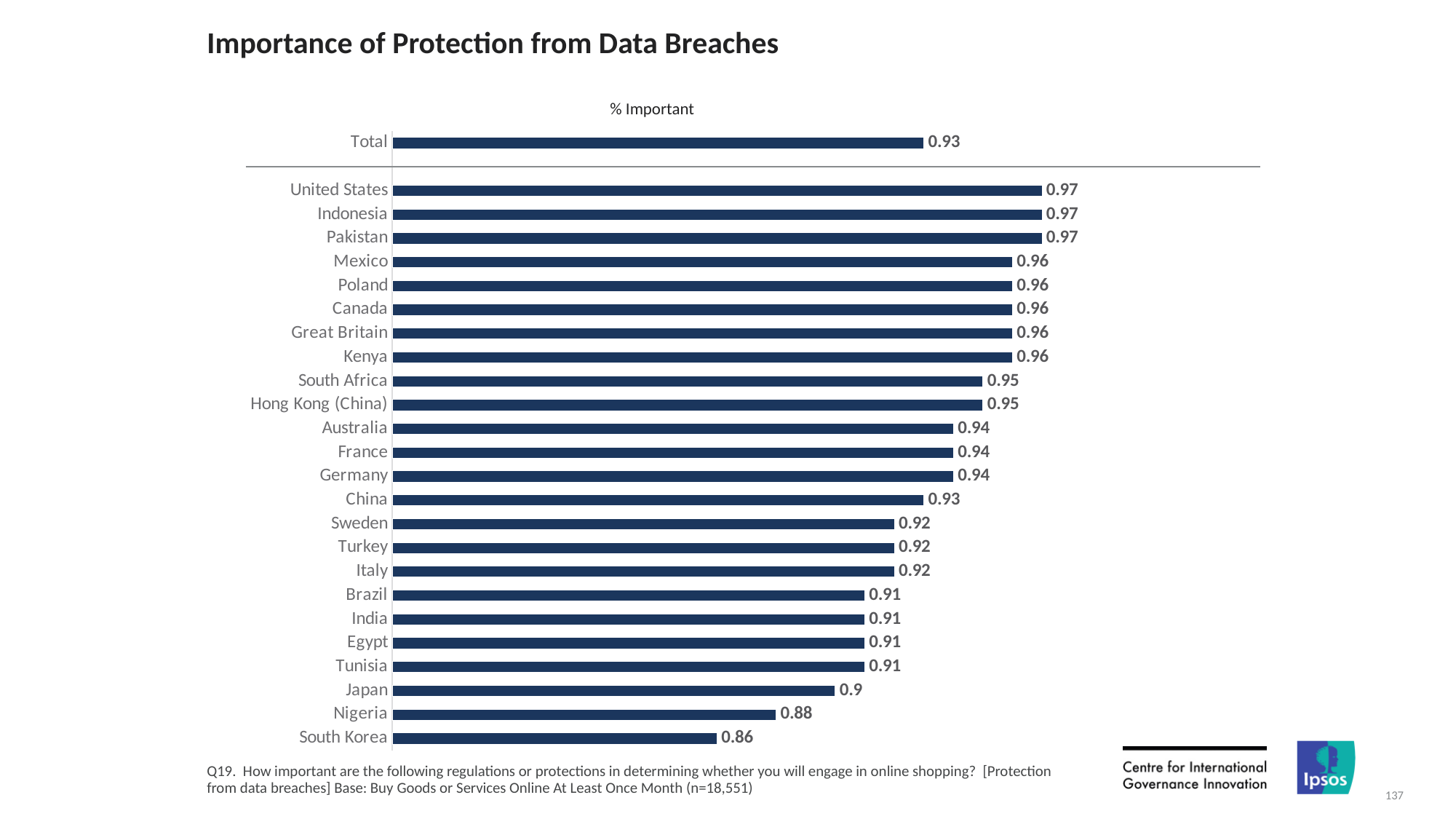
What is the difference between the values for Nigeria and South Korea? 0.02 Which country has the lowest value? South Korea What is the value for Total? 0.93 What is the value for Japan? 0.9 What is the value for Hong Kong (China)? 0.95 Which has a larger value, China or Germany? Germany What is the difference between the values for United States and South Korea? 0.11 What is the value for South Korea? 0.86 What kind of chart is shown on the slide? Bar chart What is the title of the slide? Importance of Protection from Data Breaches Which has a larger value, Japan or Nigeria? Japan How many countries are listed below the Total bar? 24